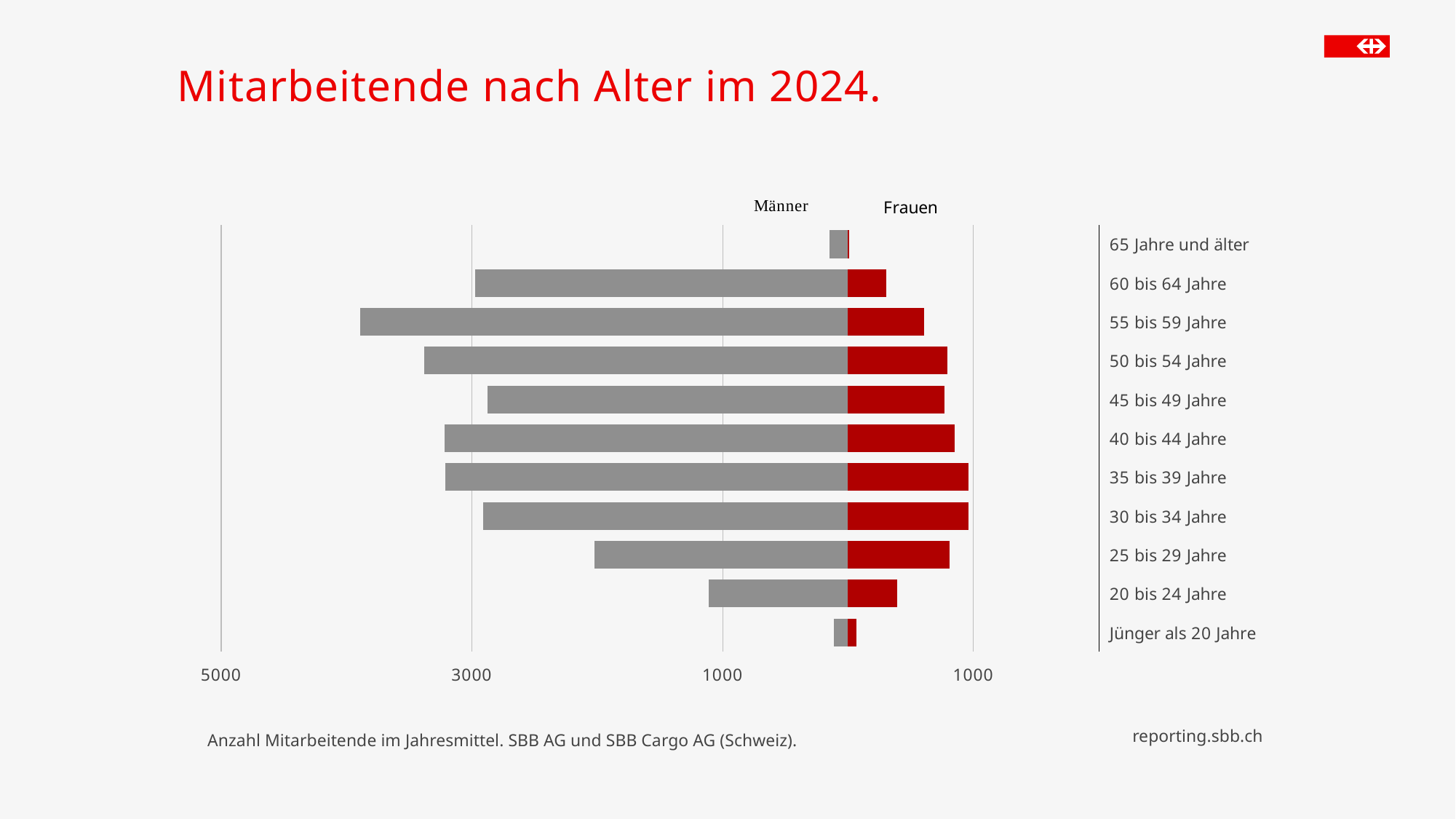
How many series does the chart show? 2 Which age category has the highest value for Männer? 55 bis 59 Jahre What kind of chart is shown on the slide? bar chart What is the title of the chart? Mitarbeitende nach Alter im 2024. In the 40 bis 44 Jahre category, which series has the larger value, Männer or Frauen? Männer Which is larger for Männer: 55 bis 59 Jahre or 45 bis 49 Jahre? 55 bis 59 Jahre Which is larger for Frauen: 25 bis 29 Jahre or 20 bis 24 Jahre? 25 bis 29 Jahre Is the Männer value for 25 bis 29 Jahre greater or less than 1000? greater How many age categories are shown in the chart? 11 Is the Männer value for 55 bis 59 Jahre greater or less than 3000? greater Is the Frauen value for 60 bis 64 Jahre greater or less than 1000? less Which age category has the lowest value for Frauen? 65 Jahre und älter